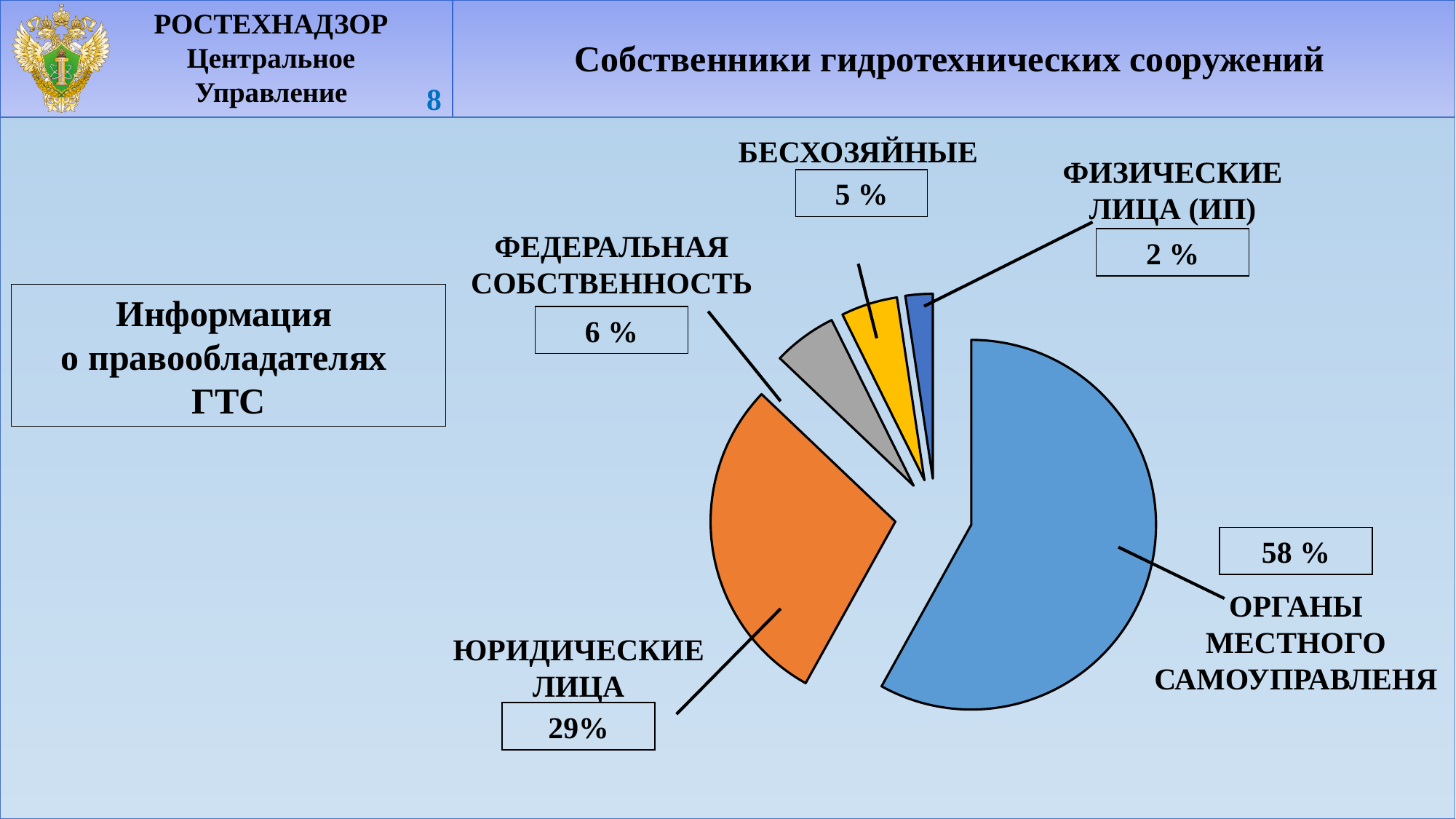
What share of the pie is labelled for ЮРИДИЧЕСКИЕ ЛИЦА? 29% What is the title of the chart on the slide? Собственники гидротехнических сооружений Which is larger, the share for ФЕДЕРАЛЬНАЯ СОБСТВЕННОСТЬ or the share for БЕСХОЗЯЙНЫЕ? ФЕДЕРАЛЬНАЯ СОБСТВЕННОСТЬ What share of the pie is labelled for ФИЗИЧЕСКИЕ ЛИЦА (ИП)? 2 % Which category has the smallest slice of the pie? ФИЗИЧЕСКИЕ ЛИЦА (ИП) What share of the pie is labelled for ОРГАНЫ МЕСТНОГО САМОУПРАВЛЕНЯ? 58 % What is the difference in percentage points between ОРГАНЫ МЕСТНОГО САМОУПРАВЛЕНЯ and ЮРИДИЧЕСКИЕ ЛИЦА? 29 How many slices does the pie chart have? 5 What share of the pie is labelled for ФЕДЕРАЛЬНАЯ СОБСТВЕННОСТЬ? 6 % Which category has the largest slice of the pie? ОРГАНЫ МЕСТНОГО САМОУПРАВЛЕНЯ What kind of chart is shown on the slide? pie chart What share of the pie is labelled for БЕСХОЗЯЙНЫЕ? 5 %